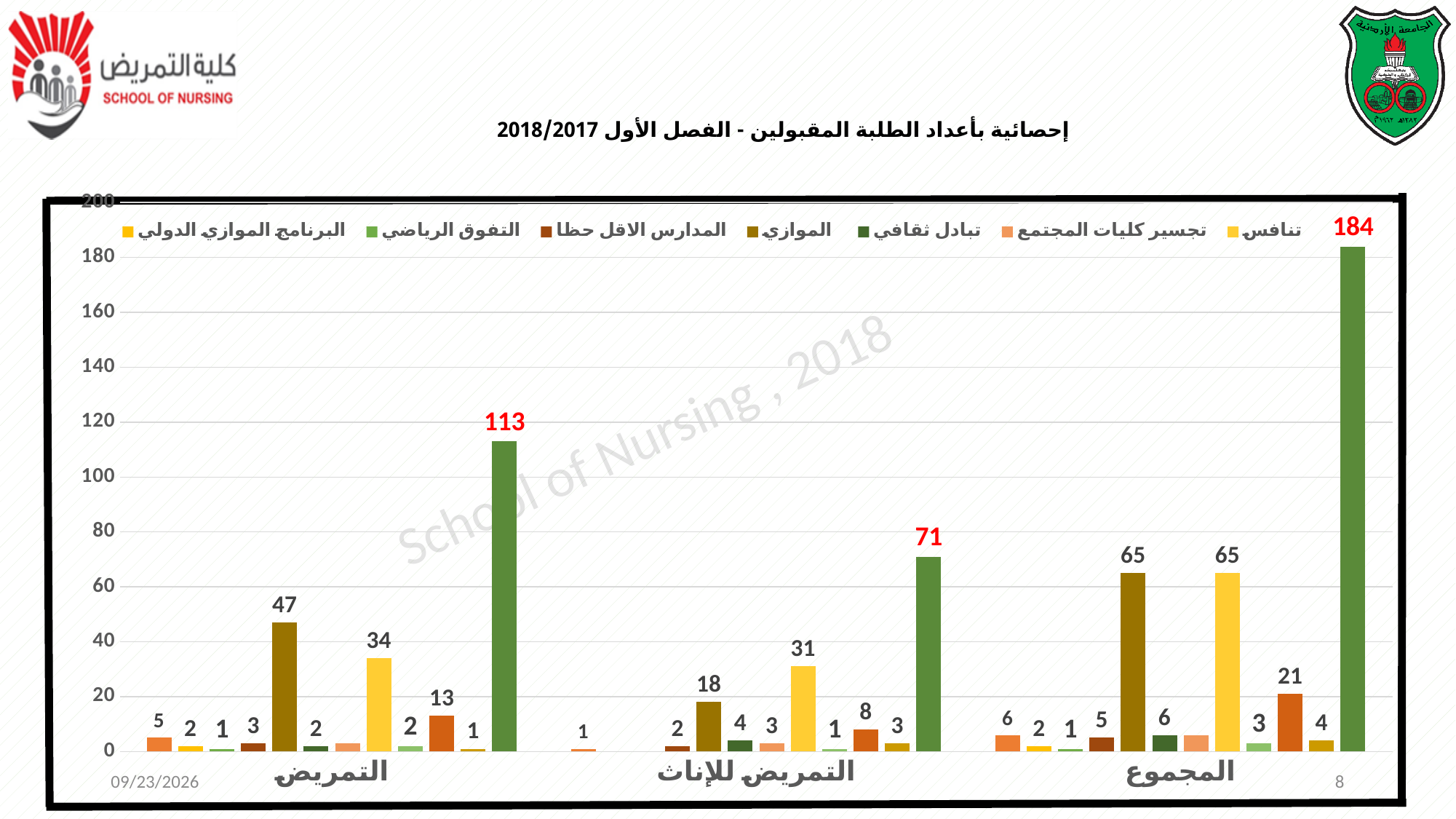
Which is larger: the tallest bar in التمريض or the tallest bar in التمريض للإناث? التمريض What is the difference between the tallest bar in التمريض (113) and the tallest bar in التمريض للإناث (71)? 42 What is the value of the tallest bar in the المجموع group? 184 What kind of chart is shown on the slide? bar chart How many categories are shown along the x axis of the chart? 3 What is the value of the الموازي bar in the المجموع group? 65 Which category contains the highest bar in the chart? المجموع What is the value of the tallest bar in the التمريض للإناث group? 71 What is the value of the tallest bar in the التمريض group? 113 What is the difference between the tallest bar in المجموع (184) and the tallest bar in التمريض (113)? 71 Is the tallest bar in the المجموع group greater or less than 160? greater What is the title of the chart? إحصائية بأعداد الطلبة المقبولين - الفصل الأول 2018/2017